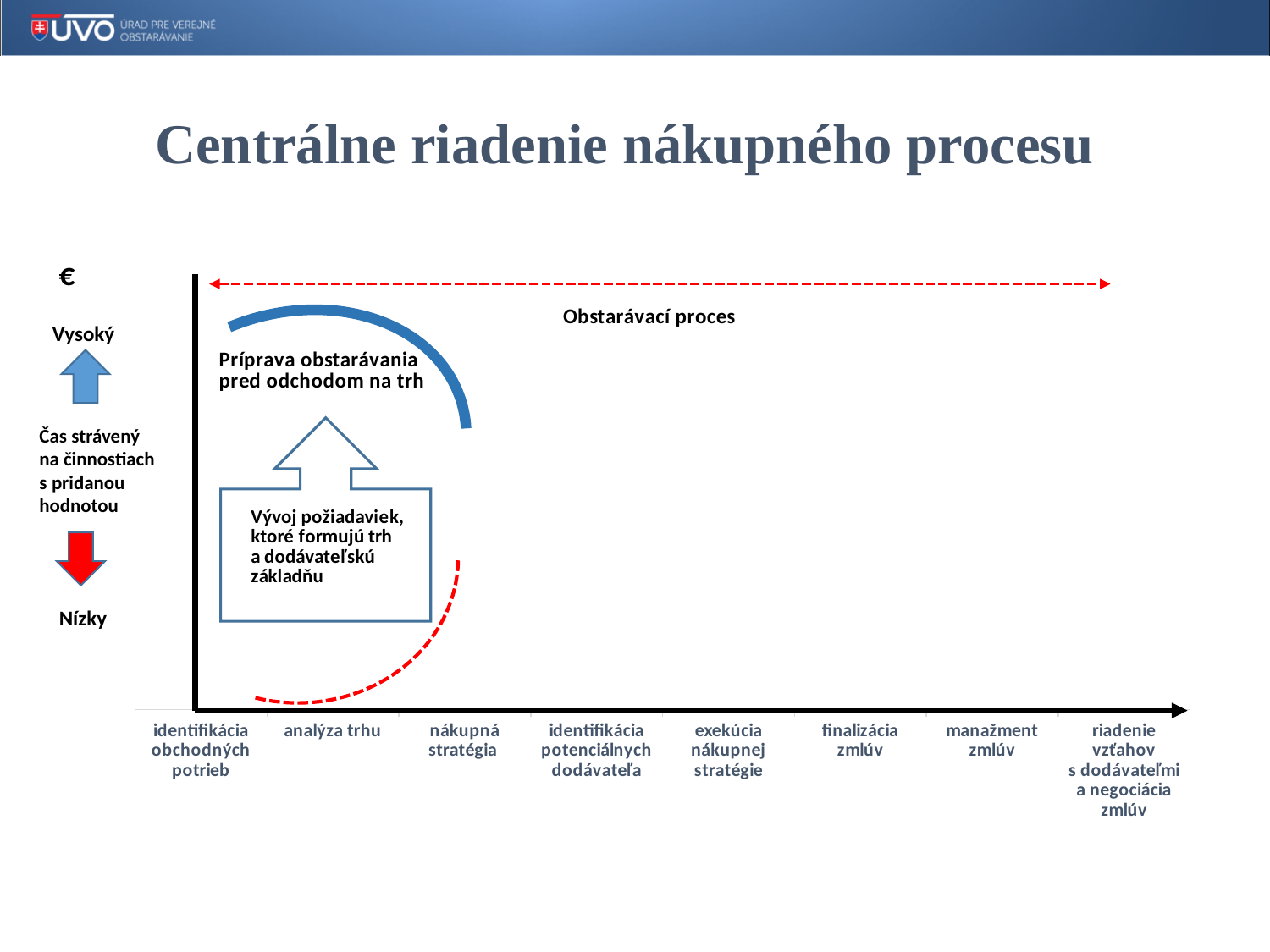
Which stage is labelled fourth from the left on the x axis? identifikácia potenciálnych dodávateľa What is the last stage labelled on the x axis of the chart? riadenie vzťahov s dodávateľmi a negociácia zmlúv What label is written at the bottom of the vertical axis scale? Nízky What is the first stage labelled on the x axis of the chart? identifikácia obchodných potrieb Does the red dashed curve rise or fall as it moves from left to right along the x axis? rise Does the solid blue curve rise or fall as it moves from left to right along the x axis? fall What label is written at the top of the vertical axis scale? Vysoký How many stages are labelled along the x axis of the chart? 8 How many curves are drawn inside the chart area? 2 What is the label of the horizontal dashed red arrow at the top of the chart? Obstarávací proces